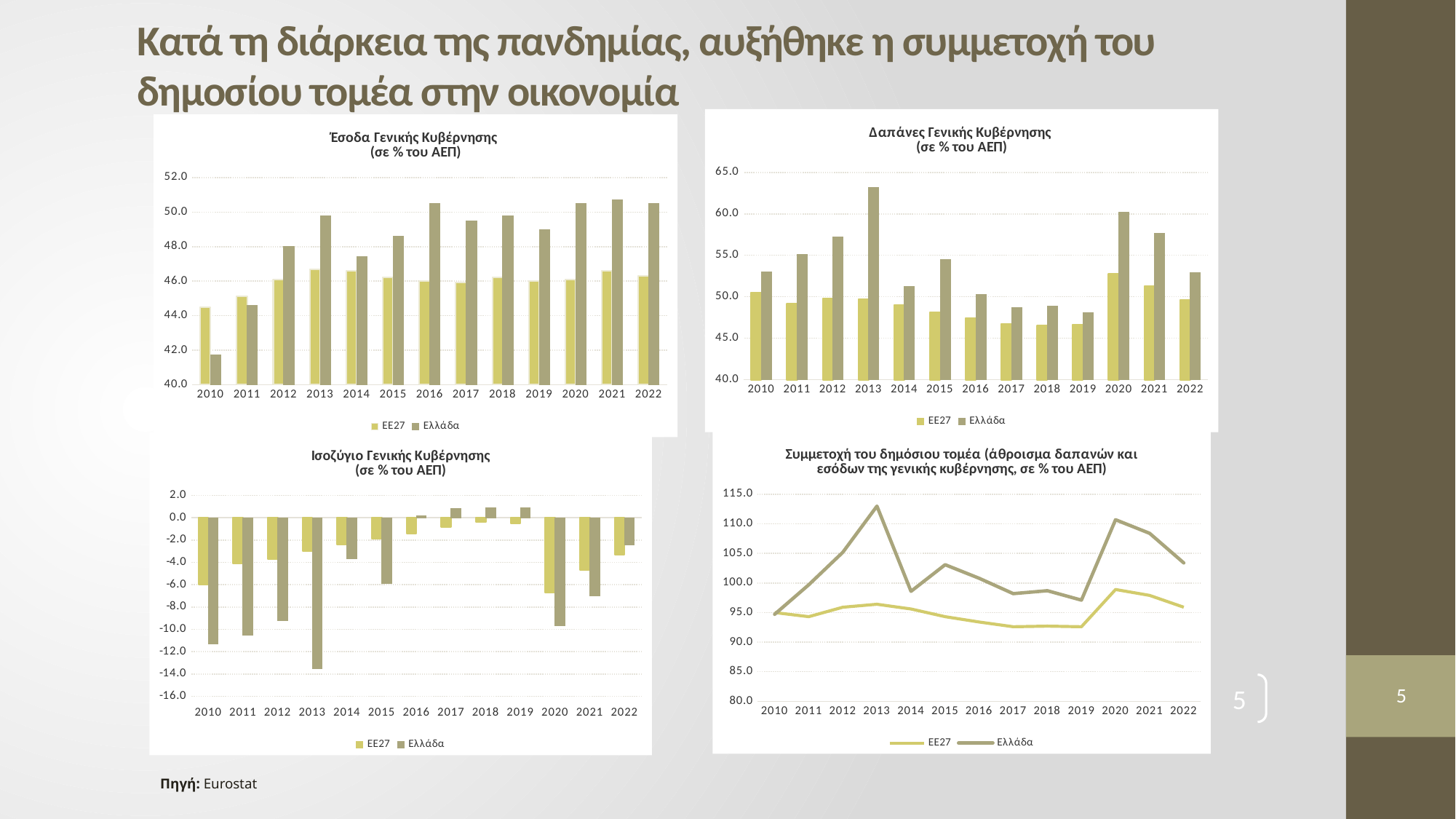
In the bottom-right chart 'Συμμετοχή του δημόσιου τομέα', is the Ελλάδα value for 2013 greater or less than 110.0? greater In the top-left chart 'Έσοδα Γενικής Κυβέρνησης', in which year is the Ελλάδα bar lowest? 2010 What kind of chart is the bottom-right chart titled 'Συμμετοχή του δημόσιου τομέα'? line chart In the top-right chart 'Δαπάνες Γενικής Κυβέρνησης', how many series does the legend list? 2 In the top-right chart 'Δαπάνες Γενικής Κυβέρνησης', is the Ελλάδα value for 2013 greater or less than 60.0? greater In the bottom-left chart 'Ισοζύγιο Γενικής Κυβέρνησης', how many years are shown on the x axis? 13 What kind of chart is the top-left chart 'Έσοδα Γενικής Κυβέρνησης'? bar chart In the bottom-left chart 'Ισοζύγιο Γενικής Κυβέρνησης', in which year is the Ελλάδα bar lowest? 2013 In the top-left chart 'Έσοδα Γενικής Κυβέρνησης', is the Ελλάδα value for 2010 greater or less than 44.0? less In the bottom-right chart 'Συμμετοχή του δημόσιου τομέα', does the EE27 line rise or fall from 2019 to 2020? rise In the top-right chart 'Δαπάνες Γενικής Κυβέρνησης', which is larger in 2020: EE27 or Ελλάδα? Ελλάδα In the top-right chart 'Δαπάνες Γενικής Κυβέρνησης', in which year is the Ελλάδα bar highest? 2013